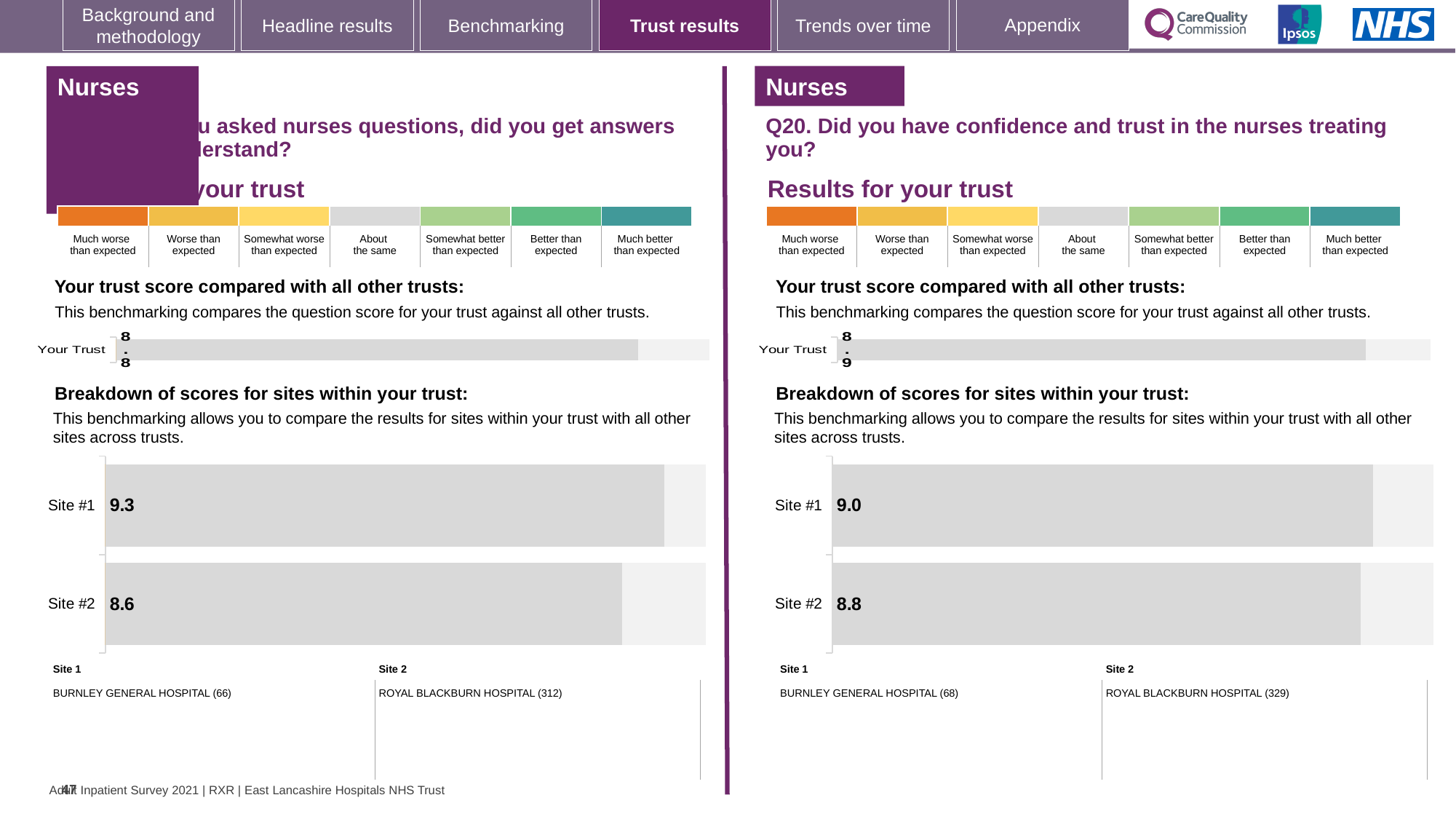
On the left-hand site breakdown chart, what is the difference between the Site #1 and Site #2 scores? 0.7 On the right-hand (Q20) site breakdown chart, which site has the lower score? Site #2 On the right-hand (Q20) site breakdown chart, what is the score for Site #2? 8.8 How many sites are shown on the right-hand (Q20) site breakdown chart? 2 On the right-hand (Q20) 'Your trust score compared with all other trusts' chart, what is the score for Your Trust? 8.9 On the left-hand 'Your trust score compared with all other trusts' chart, what is the score for Your Trust? 8.8 On the right-hand (Q20) site breakdown chart, what is the score for Site #1? 9.0 On the left-hand site breakdown chart, what is the score for Site #1? 9.3 On the left-hand site breakdown chart, what is the score for Site #2? 8.6 On the left-hand site breakdown chart, which site has the higher score? Site #1 What type of chart is used for the site breakdown on the left-hand side of the slide? Bar chart On the right-hand (Q20) site breakdown chart, what is the difference between the Site #1 and Site #2 scores? 0.2